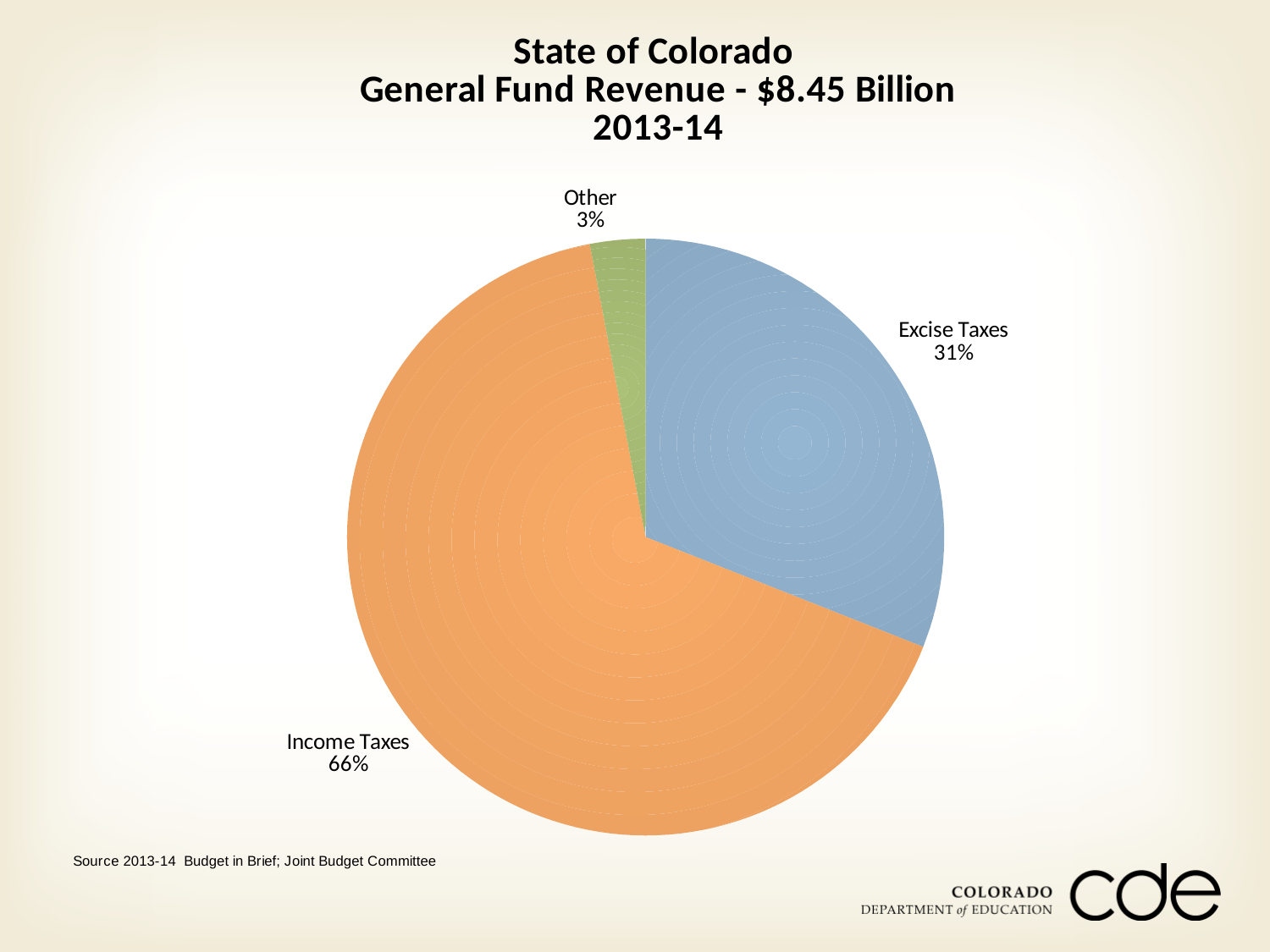
How many slices does the pie chart have? 3 What total General Fund Revenue amount is stated in the chart title? $8.45 Billion What share of General Fund Revenue is labelled Other? 3% Which fiscal year does the chart cover? 2013-14 Which revenue category has the smallest slice of the pie? Other What is the difference in percentage points between Income Taxes and Excise Taxes? 35 What share of General Fund Revenue comes from Excise Taxes? 31% What share of General Fund Revenue comes from Income Taxes? 66% What kind of chart is shown on the slide? Pie chart Which revenue category has the largest slice of the pie? Income Taxes Which is larger, the Excise Taxes share or the Other share? Excise Taxes